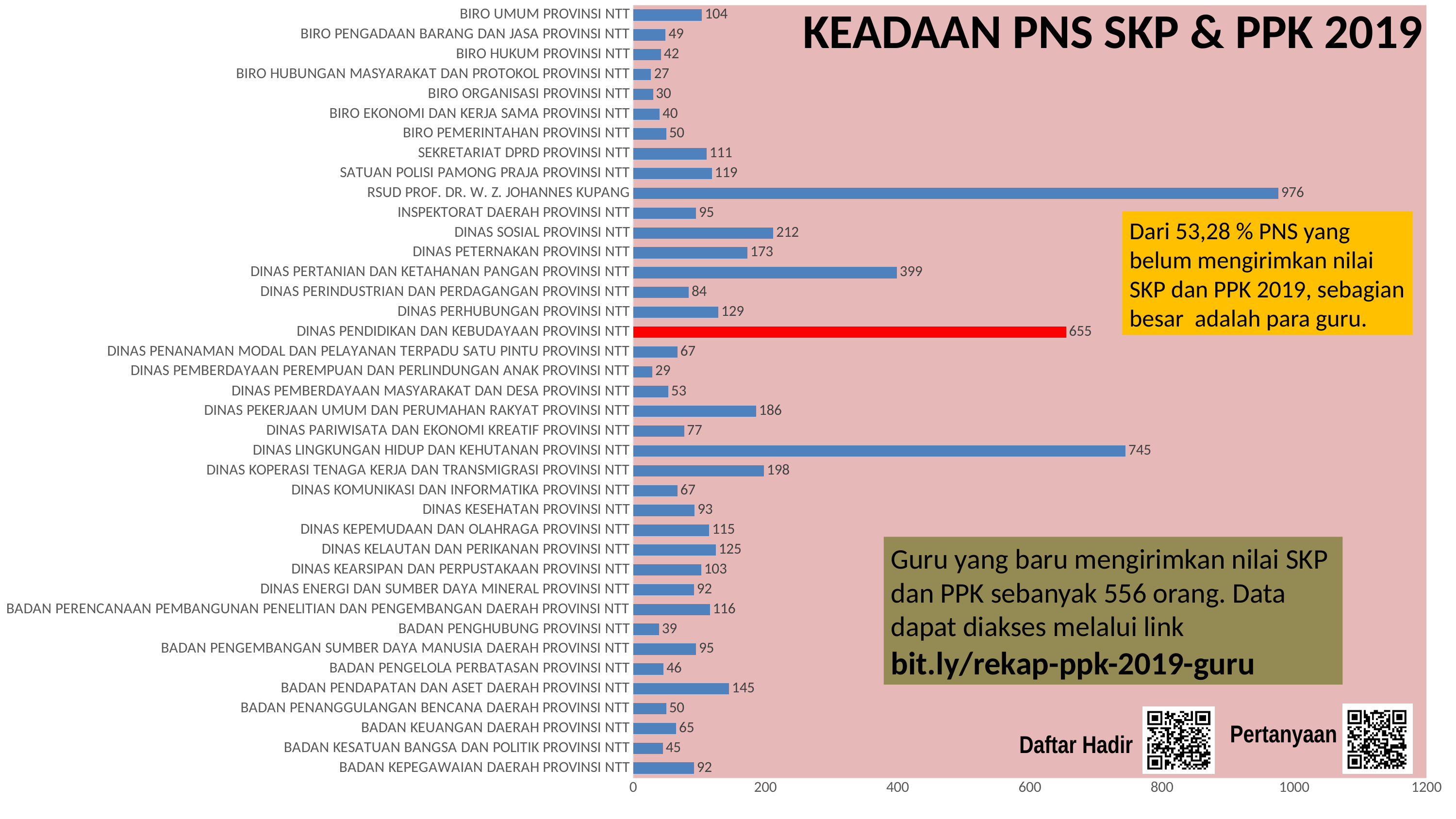
Which category has the lowest value? BIRO HUBUNGAN MASYARAKAT DAN PROTOKOL PROVINSI NTT How many categories are shown in the chart? 39 What is the value for RSUD PROF. DR. W. Z. JOHANNES KUPANG? 976 Which category's bar is coloured red? DINAS PENDIDIKAN DAN KEBUDAYAAN PROVINSI NTT What is the value for DINAS PENDIDIKAN DAN KEBUDAYAAN PROVINSI NTT? 655 Is the value for DINAS PENDIDIKAN DAN KEBUDAYAAN PROVINSI NTT greater or less than 600? greater What is the value for DINAS LINGKUNGAN HIDUP DAN KEHUTANAN PROVINSI NTT? 745 Which is larger, the value for DINAS PERTANIAN DAN KETAHANAN PANGAN PROVINSI NTT or DINAS SOSIAL PROVINSI NTT? DINAS PERTANIAN DAN KETAHANAN PANGAN PROVINSI NTT Which category has the highest value? RSUD PROF. DR. W. Z. JOHANNES KUPANG What kind of chart is shown on the slide? bar chart What is the difference between the values for RSUD PROF. DR. W. Z. JOHANNES KUPANG and DINAS LINGKUNGAN HIDUP DAN KEHUTANAN PROVINSI NTT? 231 What is the title of the slide? KEADAAN PNS SKP & PPK 2019